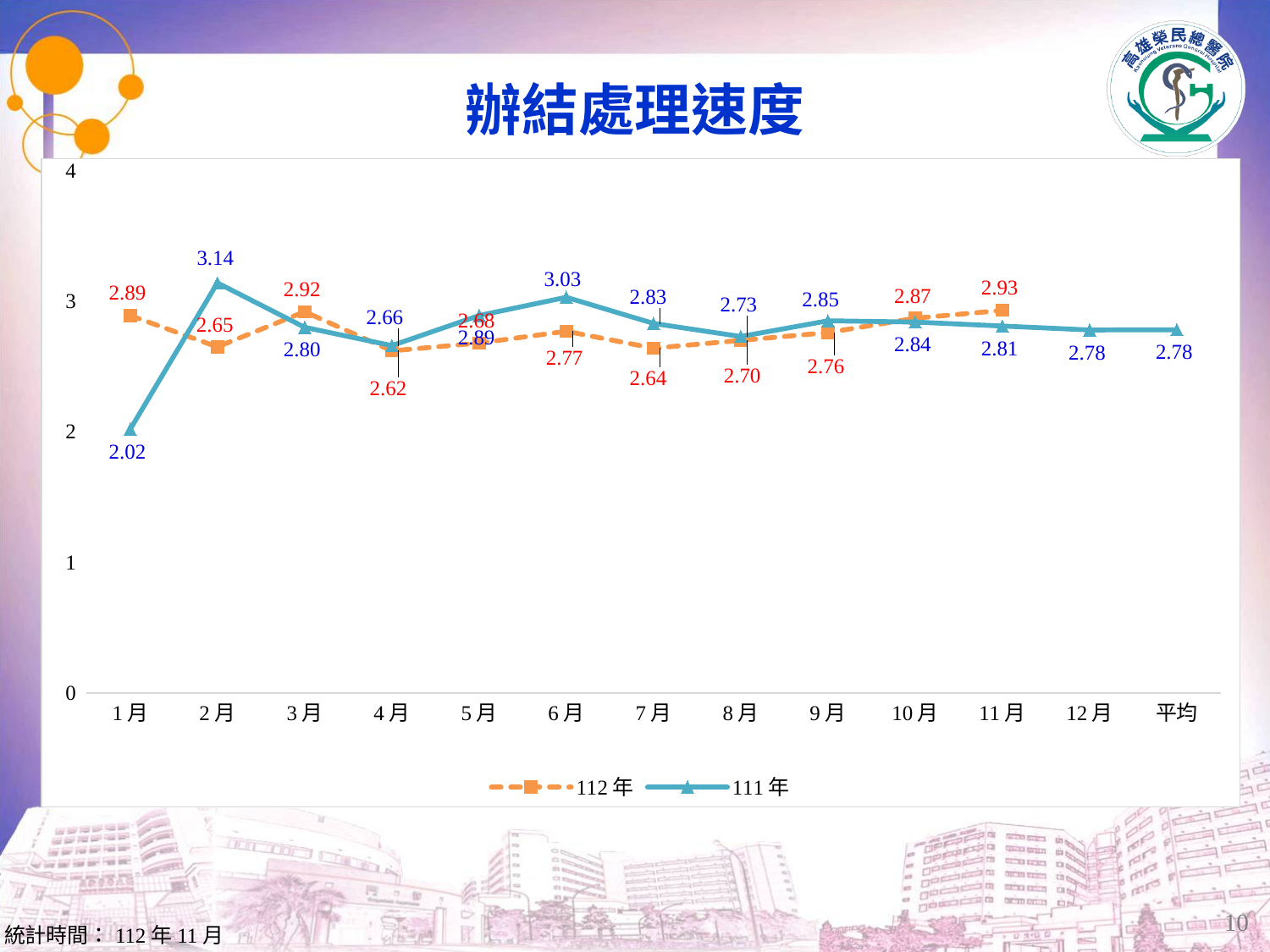
What is the 平均 value for 111年? 2.78 In which month is the 111年 value lowest? 1月 What is the value for 112年 in 11月? 2.93 In which month is the 111年 value highest? 2月 What is the value for 112年 in 4月? 2.62 What is the value for 111年 in 2月? 3.14 What is the difference between the 111年 values in 2月 and 1月? 1.12 How many categories are shown on the x axis? 13 In 1月, which series has the higher value, 112年 or 111年? 112年 In which month is the 112年 value highest? 11月 In 6月, how much higher is the 111年 value than the 112年 value? 0.26 How many series does the legend list? 2